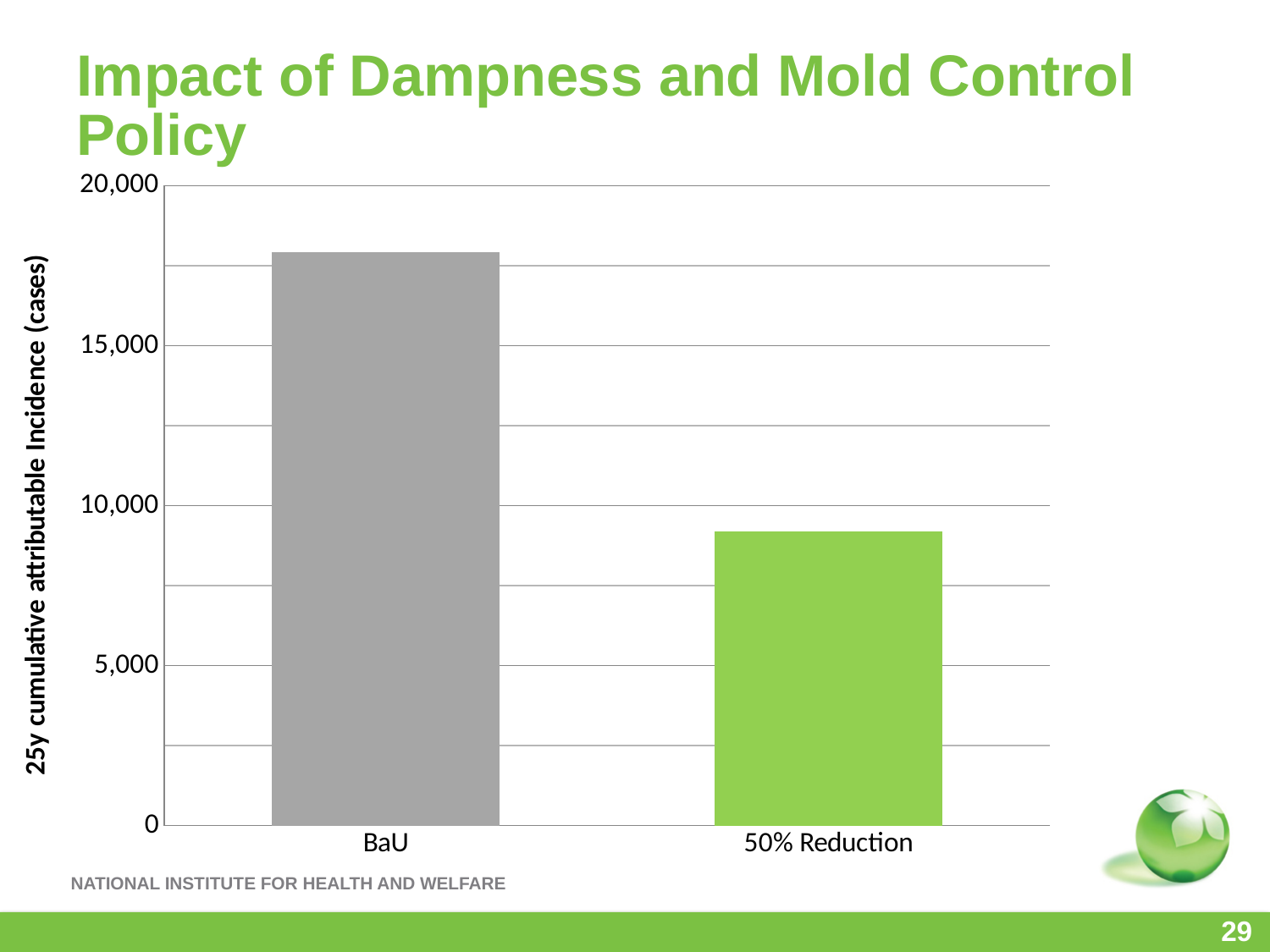
Is the value for BaU greater or less than 20,000? less Which category has the lowest 25y cumulative attributable incidence? 50% Reduction What colour is the bar for 50% Reduction? green Is the value for 50% Reduction greater or less than 10,000? less What kind of chart is shown on the slide? bar chart What is the label of the y axis? 25y cumulative attributable Incidence (cases) How many categories are plotted on the x axis? 2 Which is larger, the value for BaU or the value for 50% Reduction? BaU Which category has the highest 25y cumulative attributable incidence? BaU Is the value for 50% Reduction greater or less than 5,000? greater